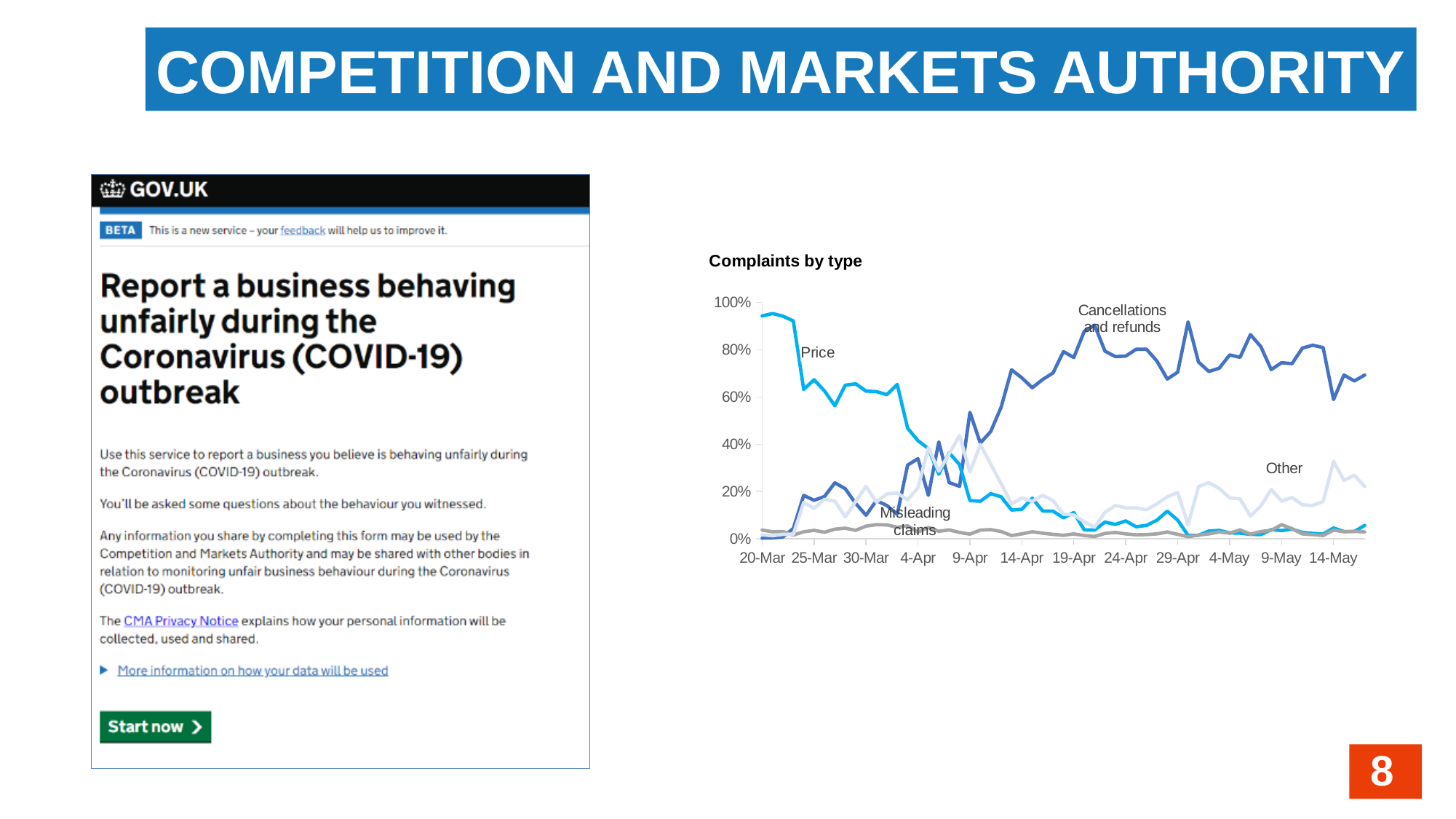
On the 'Complaints by type' chart, is the value for Cancellations and refunds on 20-Mar greater or less than 20%? less On the 'Complaints by type' chart, does the Cancellations and refunds line rise or fall from 20-Mar to 14-May? rise On the 'Complaints by type' chart, which complaint type has the highest share on 20-Mar? Price On the 'Complaints by type' chart, is the value for Price on 20-Mar greater or less than 80%? greater On the 'Complaints by type' chart, is the value for Price on 25-Mar greater or less than 40%? greater What is the title of the chart on the slide? Complaints by type How many complaint types are labelled on the 'Complaints by type' chart? 4 What kind of chart is the 'Complaints by type' chart? line chart On the 'Complaints by type' chart, which is larger on 14-May: Cancellations and refunds or Price? Cancellations and refunds On the 'Complaints by type' chart, does the Price line rise or fall from 20-Mar to 14-May? fall On the 'Complaints by type' chart, which complaint type has the highest share on 9-May? Cancellations and refunds